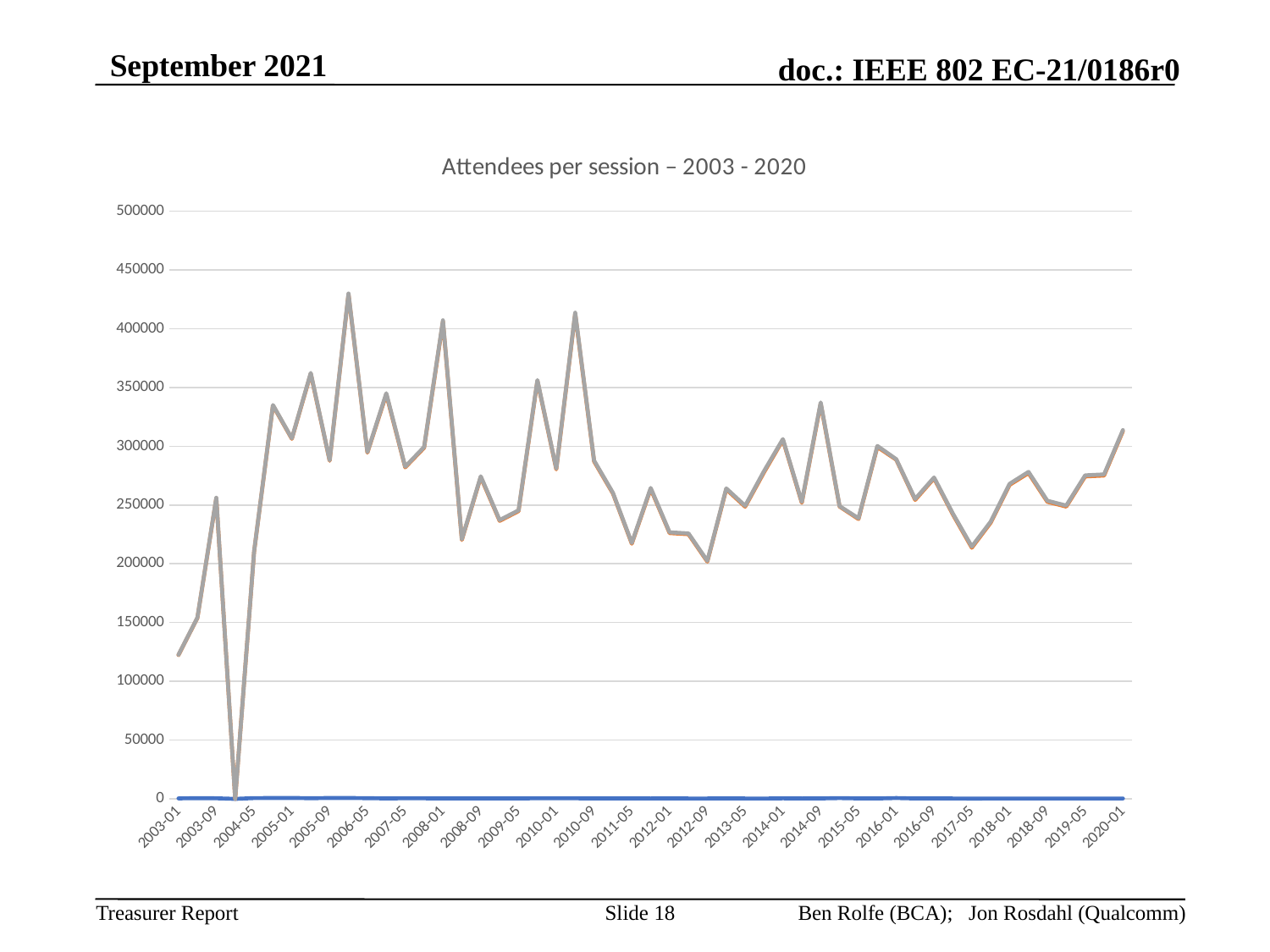
Which has the larger value, 2003-01 or 2020-01? 2020-01 Is the value for 2020-01 greater or less than 250000? greater What is the highest value shown on the y axis? 500000 What kind of chart is shown on the slide? line chart How many labels are shown on the x axis? 26 Which has the larger value, 2003-01 or 2017-05? 2017-05 Is the value for 2017-05 greater or less than 300000? less Is the value for 2003-01 greater or less than 150000? less What is the title of the chart? Attendees per session – 2003 - 2020 Does the line rise or fall between 2003-01 and 2003-09? rise